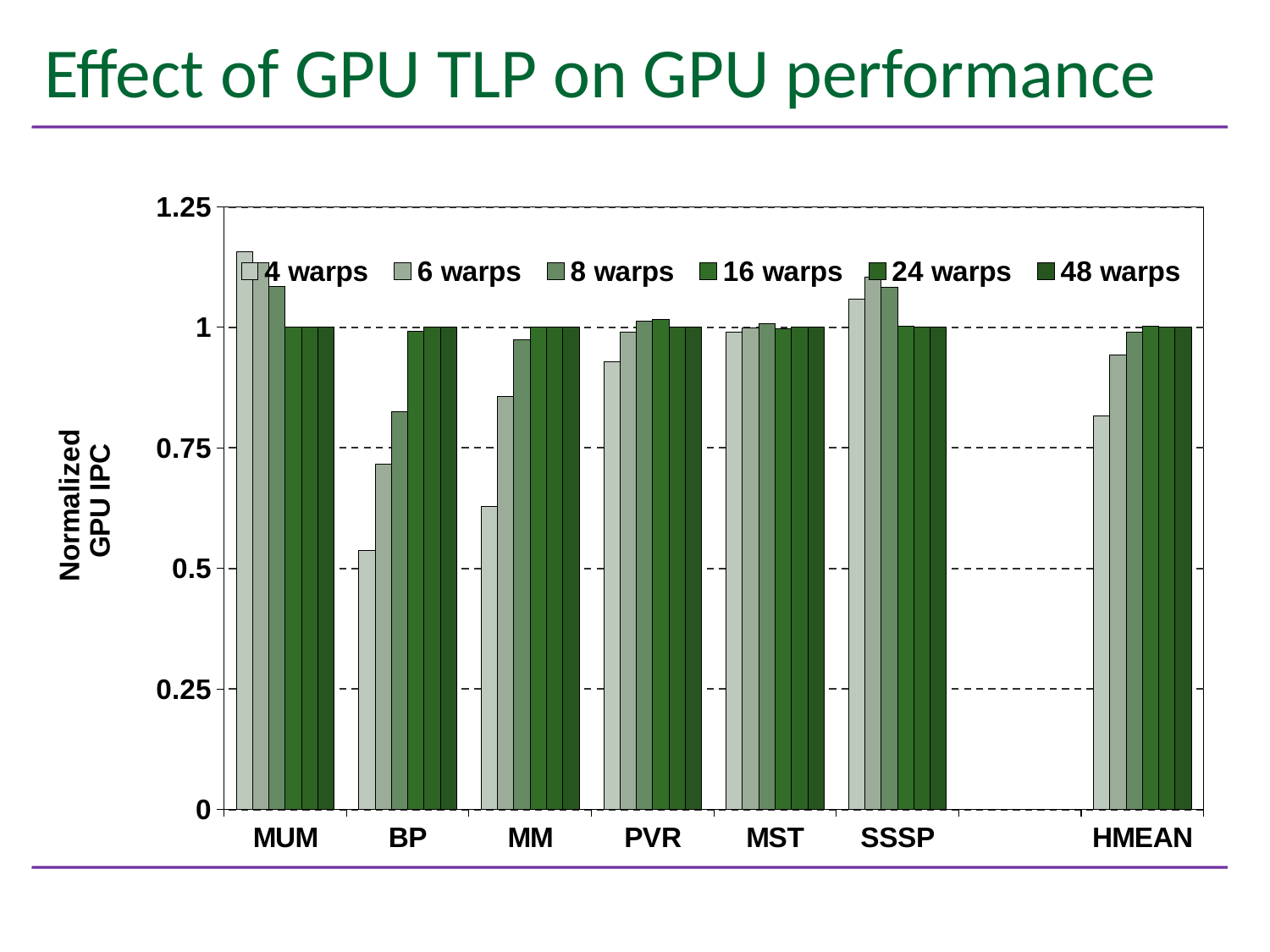
Which benchmark has the lowest 4 warps value? BP Is the 4 warps value for MM greater or less than 0.5? greater What is the label of the y axis? Normalized GPU IPC How many benchmark categories are shown on the x axis? 7 Is the 4 warps value for MUM greater or less than 1? greater Is the 4 warps value for BP greater or less than 0.75? less What kind of chart is shown on the slide? bar chart Which is larger, the 4 warps value for MUM or the 4 warps value for BP? MUM How many series does the legend list? 6 For BP, do the values rise or fall as the number of warps increases from 4 to 48? rise